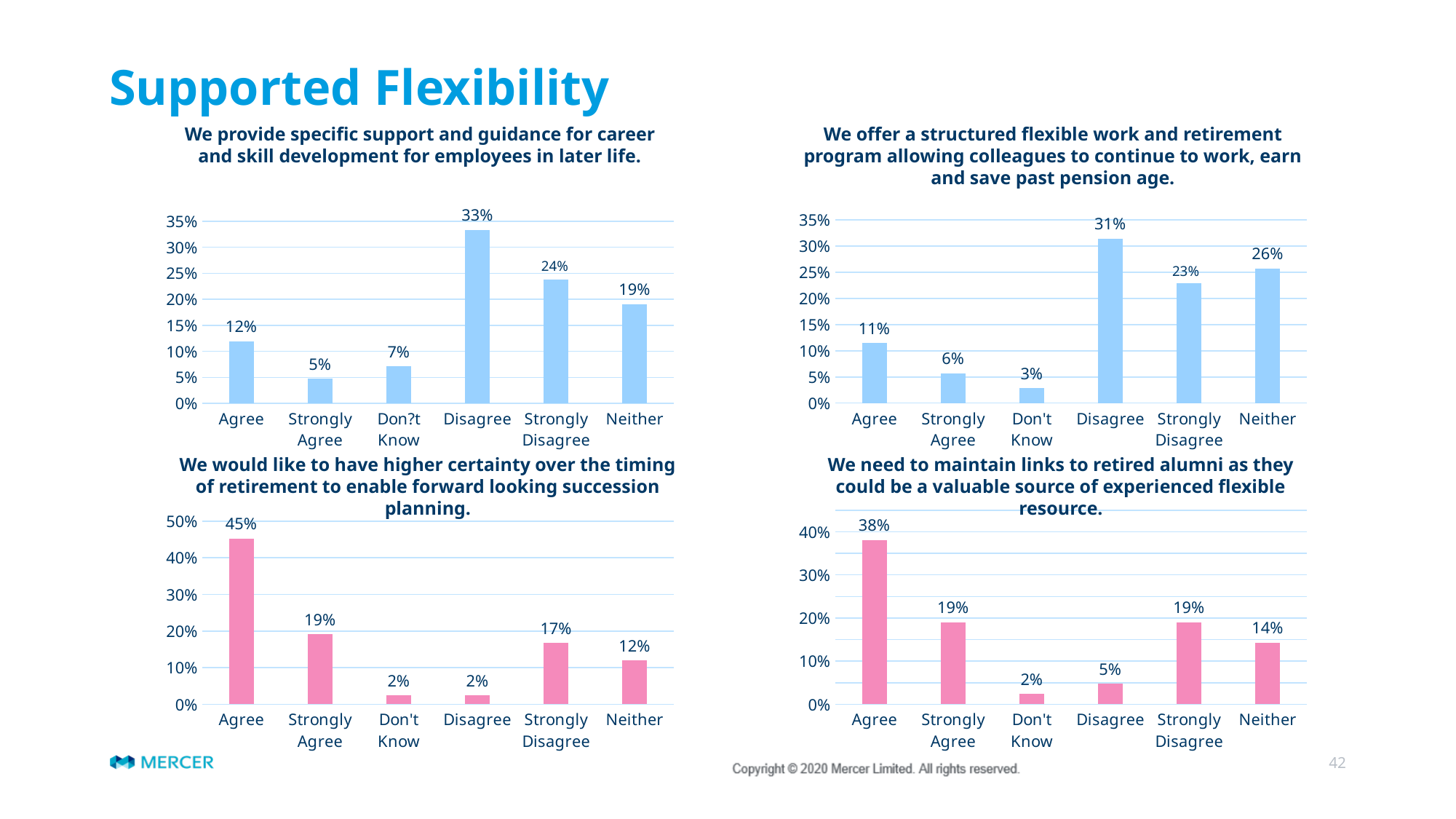
In the bottom-right chart ("We need to maintain links to retired alumni..."), what is the value for Disagree? 5% In the bottom-right chart ("We need to maintain links to retired alumni..."), what is the difference between Agree and Neither? 24% In the bottom-left chart ("We would like to have higher certainty over the timing of retirement..."), which is larger, Strongly Agree or Strongly Disagree? Strongly Agree In the top-left chart ("We provide specific support and guidance for career and skill development for employees in later life"), what is the value for Disagree? 33% In the top-right chart ("We offer a structured flexible work and retirement program..."), what is the difference between Disagree and Strongly Disagree? 8% In the bottom-right chart ("We need to maintain links to retired alumni..."), which category has the highest value? Agree In the top-left chart ("We provide specific support and guidance..."), which category has the lowest value? Strongly Agree In the top-right chart ("We offer a structured flexible work and retirement program..."), which category has the highest value? Disagree What type of chart is the bottom-left chart ("We would like to have higher certainty over the timing of retirement...")? Bar chart In the bottom-left chart ("We would like to have higher certainty over the timing of retirement..."), what is the value for Agree? 45% In the top-right chart ("We offer a structured flexible work and retirement program..."), what is the value for Neither? 26% How many categories are shown on the x axis of the top-left chart ("We provide specific support and guidance...")? 6